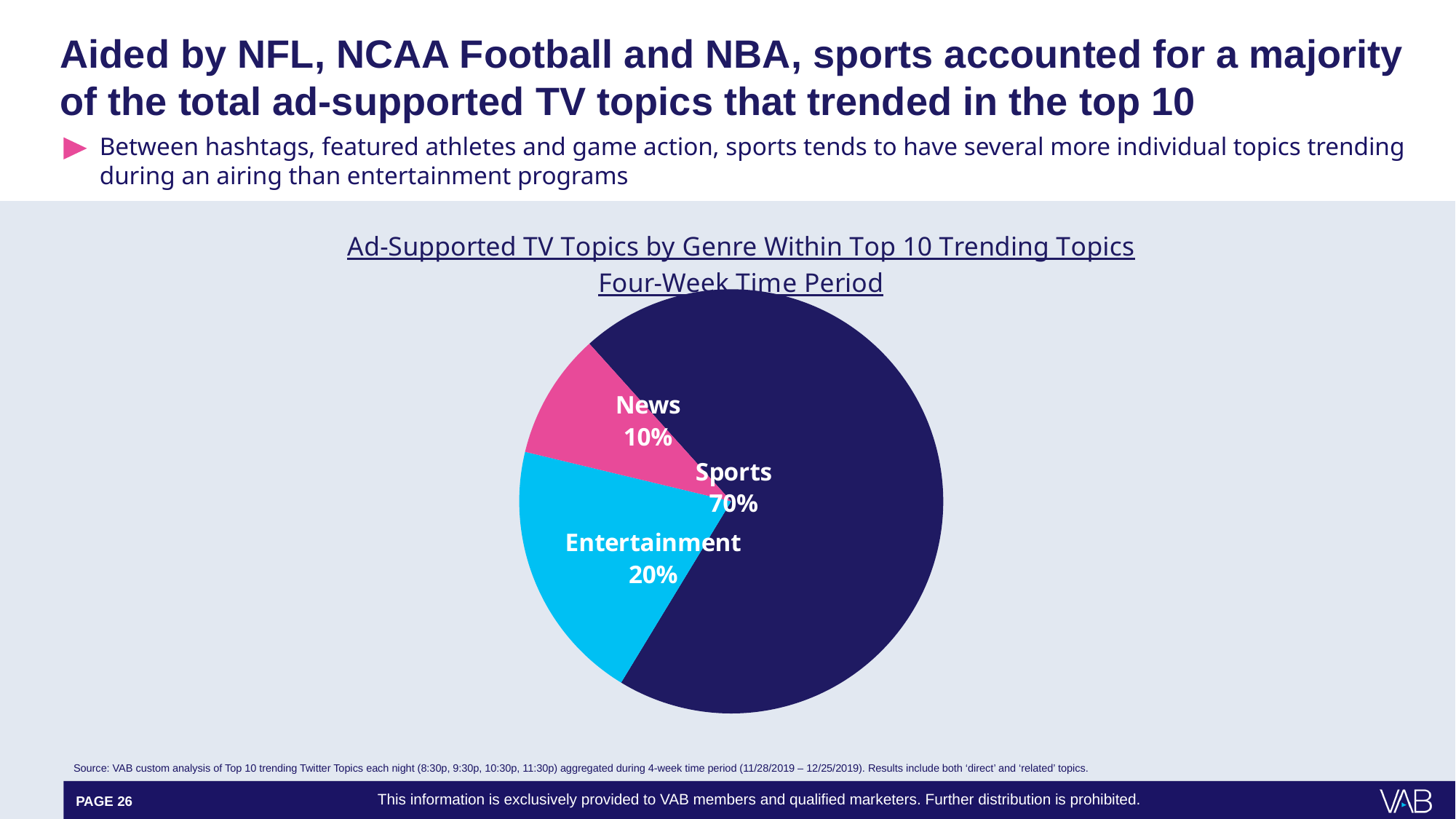
What colour is the Entertainment slice? Light blue What is the difference in percentage points between the Entertainment and News slices? 10 percentage points Which genre has the smallest slice of the pie? News Which slice is larger, Entertainment or News? Entertainment What kind of chart is shown on the slide? Pie chart What is the title of the chart? Ad-Supported TV Topics by Genre Within Top 10 Trending Topics Four-Week Time Period Which genre has the largest slice of the pie? Sports What share of the pie does Entertainment account for? 20% What share of the pie does Sports account for? 70% What is the difference in percentage points between the Sports and Entertainment slices? 50 percentage points What share of the pie does News account for? 10% How many genres are shown in the pie chart? 3